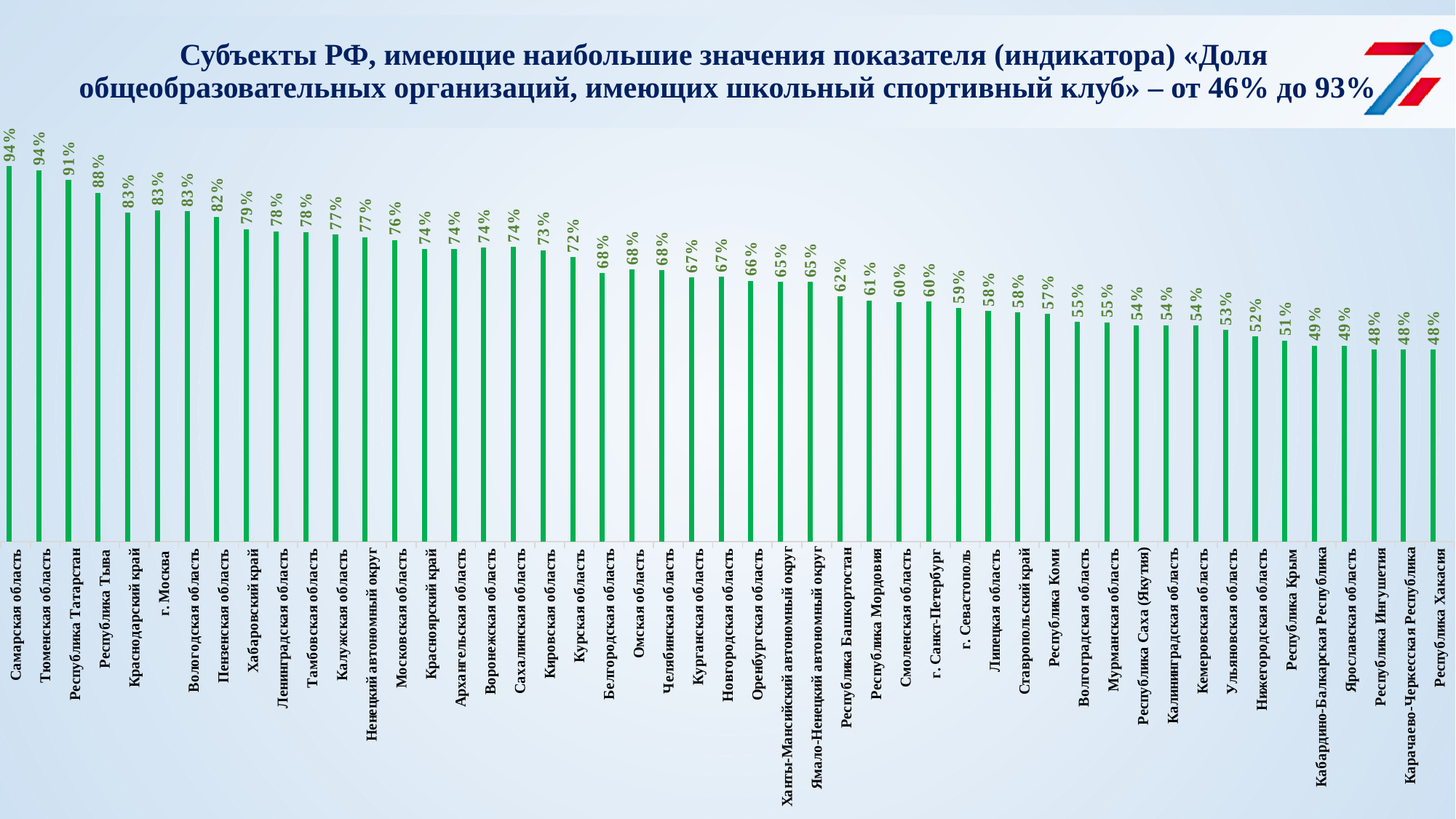
What is the highest value shown in the chart? 94% What is the lowest value shown in the chart? 48% What type of chart is shown on the slide? Bar chart What is the difference between the values for Республика Тыва and Курская область? 16% What is the value for Московская область? 76% What is the value for г. Санкт-Петербург? 60% How many regions (bars) are shown in the chart? 49 Do the values rise or fall from left to right along the x axis? Fall What is the value for Республика Крым? 51% What is the value for г. Москва? 83% Which has a larger value, Хабаровский край or Ставропольский край? Хабаровский край What is the value for Республика Татарстан? 91%